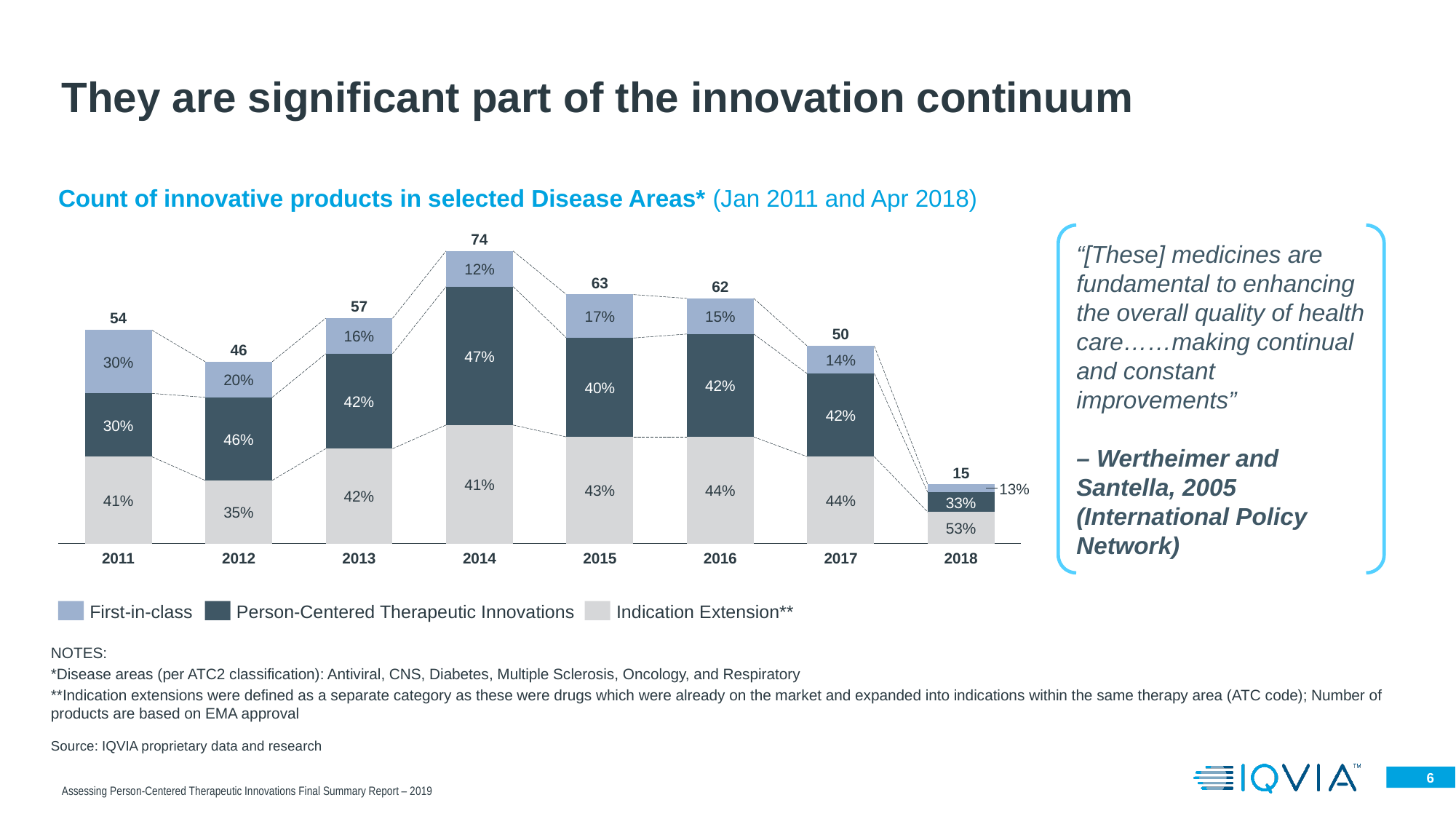
How many series does the legend list? 3 Which series is shown in the lightest grey colour at the bottom of each bar? Indication Extension** How many years are shown on the x axis? 8 What percentage share does First-in-class have in 2011? 30% Which year has a larger total count, 2015 or 2016? 2015 What kind of chart is shown on the slide? Stacked bar chart Which year has the lowest total count of innovative products? 2018 What is the total count of innovative products shown for 2014? 74 What percentage share does Indication Extension** have in 2018? 53% What is the difference between the total counts for 2014 and 2012? 28 Which year has the highest total count of innovative products? 2014 What percentage share does Person-Centered Therapeutic Innovations have in 2014? 47%